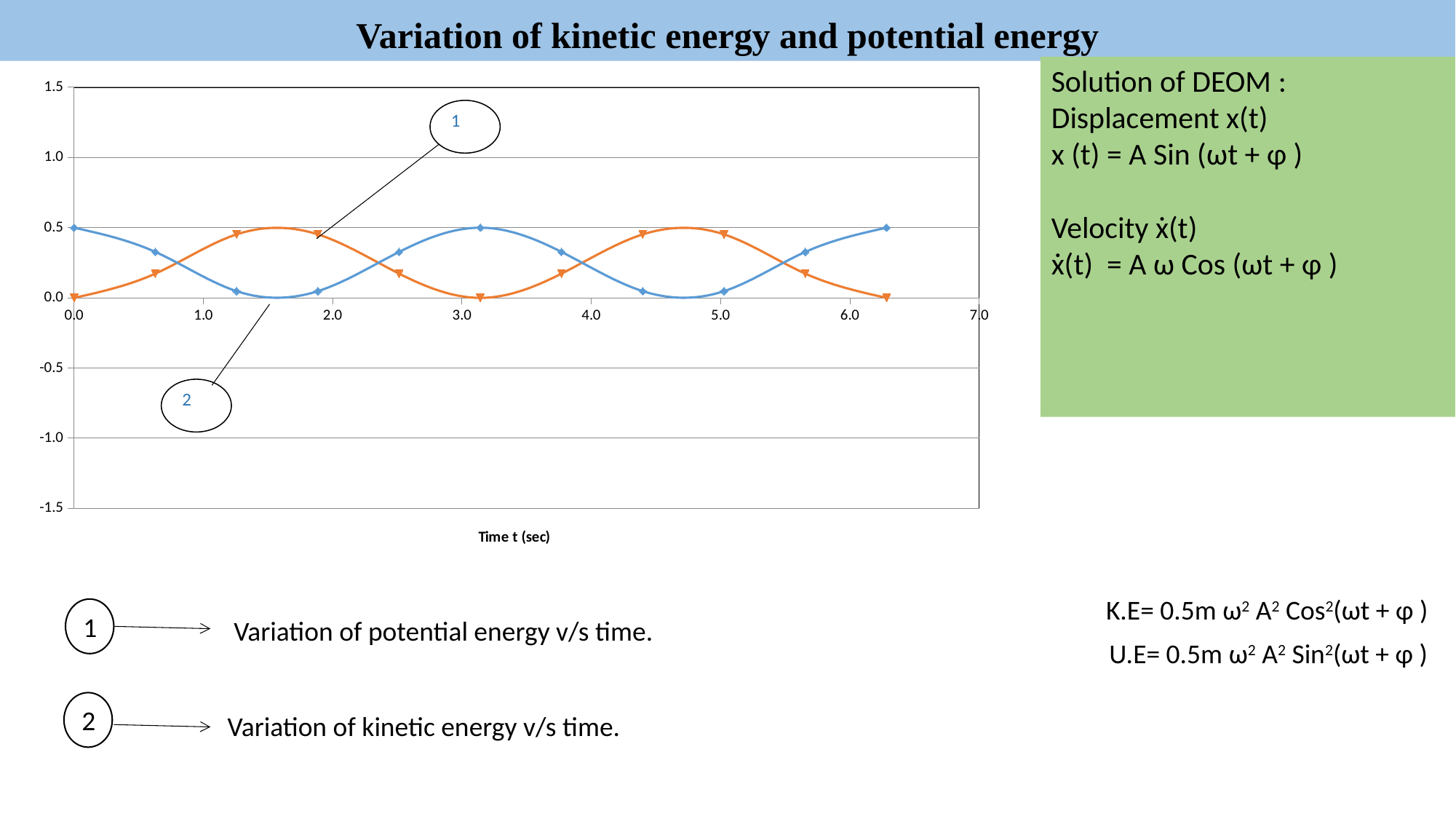
Is the value of the orange curve at time 1.0 greater or less than 0.0? greater According to the slide, which quantity does the curve labelled 1 represent? potential energy Is the value of the blue curve at time 3.0 greater or less than 0.0? greater What kind of chart is shown on the slide? line chart Does the orange curve rise or fall between time 0.0 and time 1.5? rise Does the blue curve rise or fall between time 0.0 and time 1.5? fall What is the value of the blue curve at time 0.0? 0.5 At time 0.0, which curve has the larger value, the blue one or the orange one? blue How many curves are plotted on the chart? 2 What is the title of the horizontal axis of the chart? Time t (sec) What is the value of the orange curve at time 0.0? 0.0